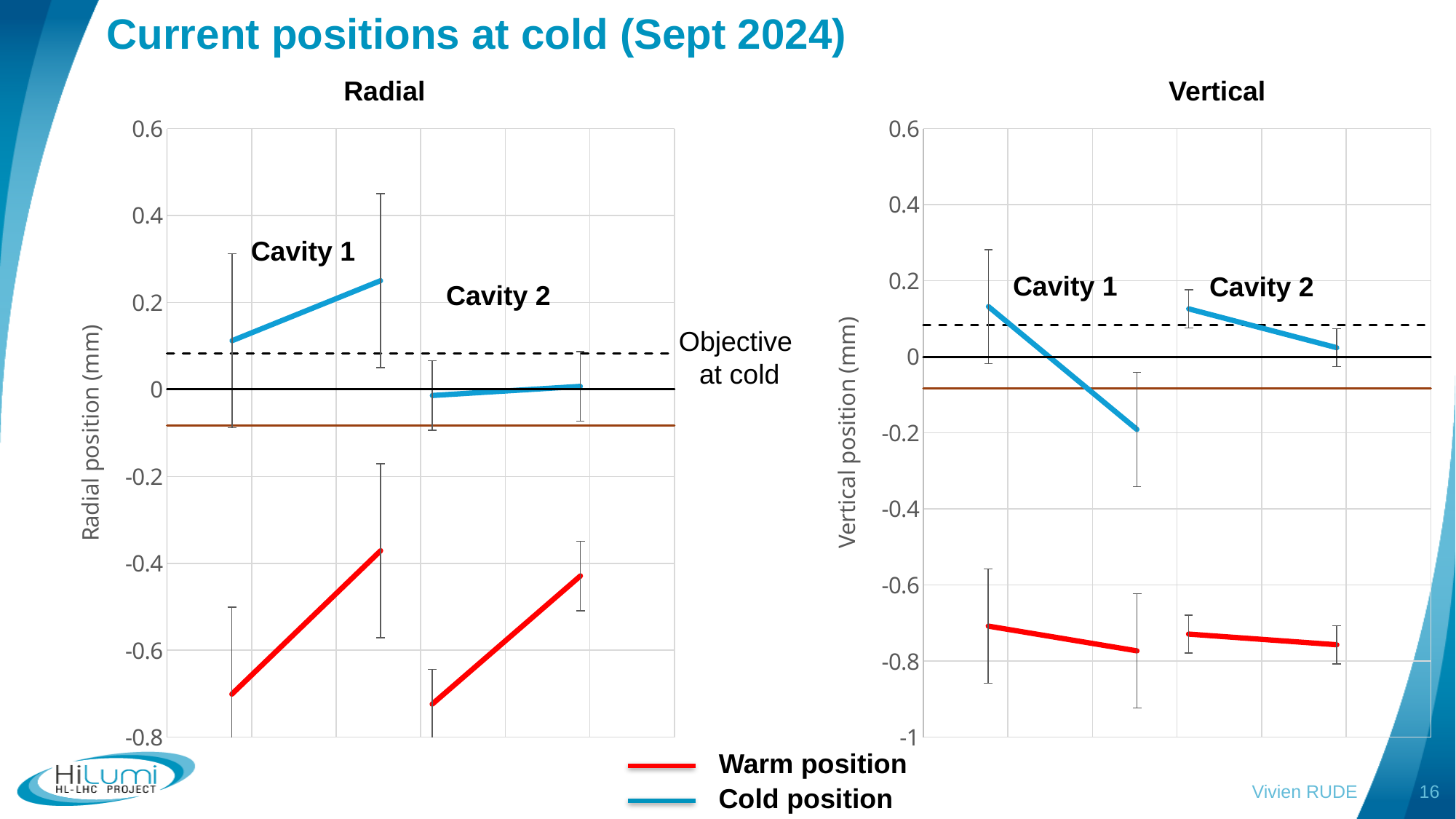
In the Radial chart, is the right end of the Cavity 1 cold position line greater or less than 0.2? greater What does the dashed horizontal line on the charts represent? Objective at cold In the Vertical chart, is the right end of the Cavity 1 cold position line greater or less than 0? less In the Radial chart, which is higher for Cavity 1: the cold position or the warm position? Cold position In the Vertical chart, does the Cavity 1 cold position line rise or fall from left to right? fall In the Vertical chart, is the right end of the Cavity 1 warm position line greater or less than -0.6? less What are the two series named in the legend? Warm position, Cold position How many series does the legend list? 2 What kind of chart is the Radial chart? line chart In the Radial chart, does the Cavity 1 warm position line rise or fall from left to right? rise How many cavities are labelled in the Vertical chart? 2